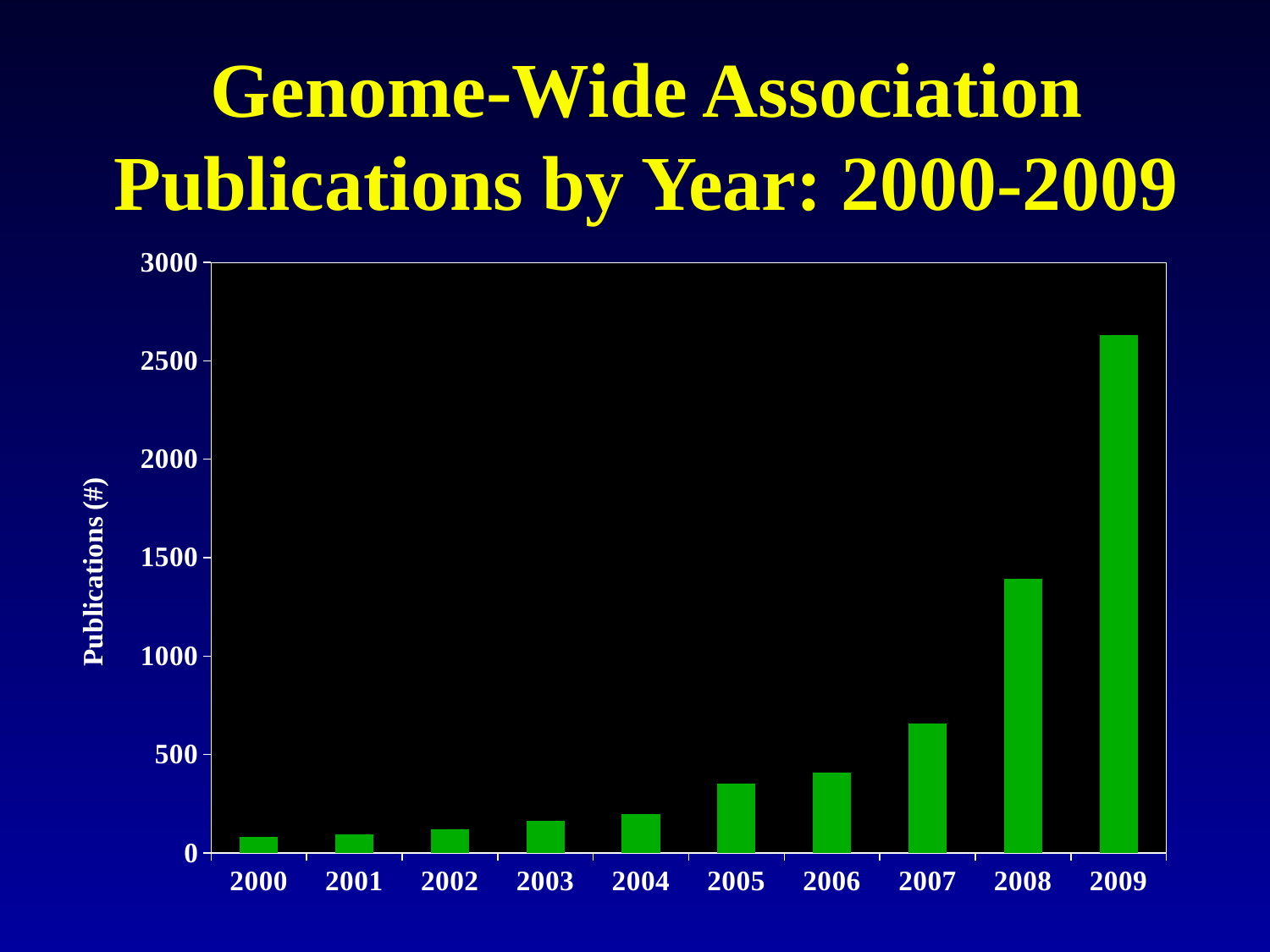
Is the value for 2007 greater or less than 500? greater What kind of chart is shown on the slide? Bar chart Is the value for 2004 greater or less than 500? less Which year has more publications, 2008 or 2007? 2008 Which year has the highest number of publications? 2009 Is the value for 2009 greater or less than 2500? greater Do the publication counts generally rise or fall from 2000 to 2009? Rise What colour are the bars in the chart? Green What is the label on the vertical axis of the chart? Publications (#) How many years (bars) are plotted on the chart? 10